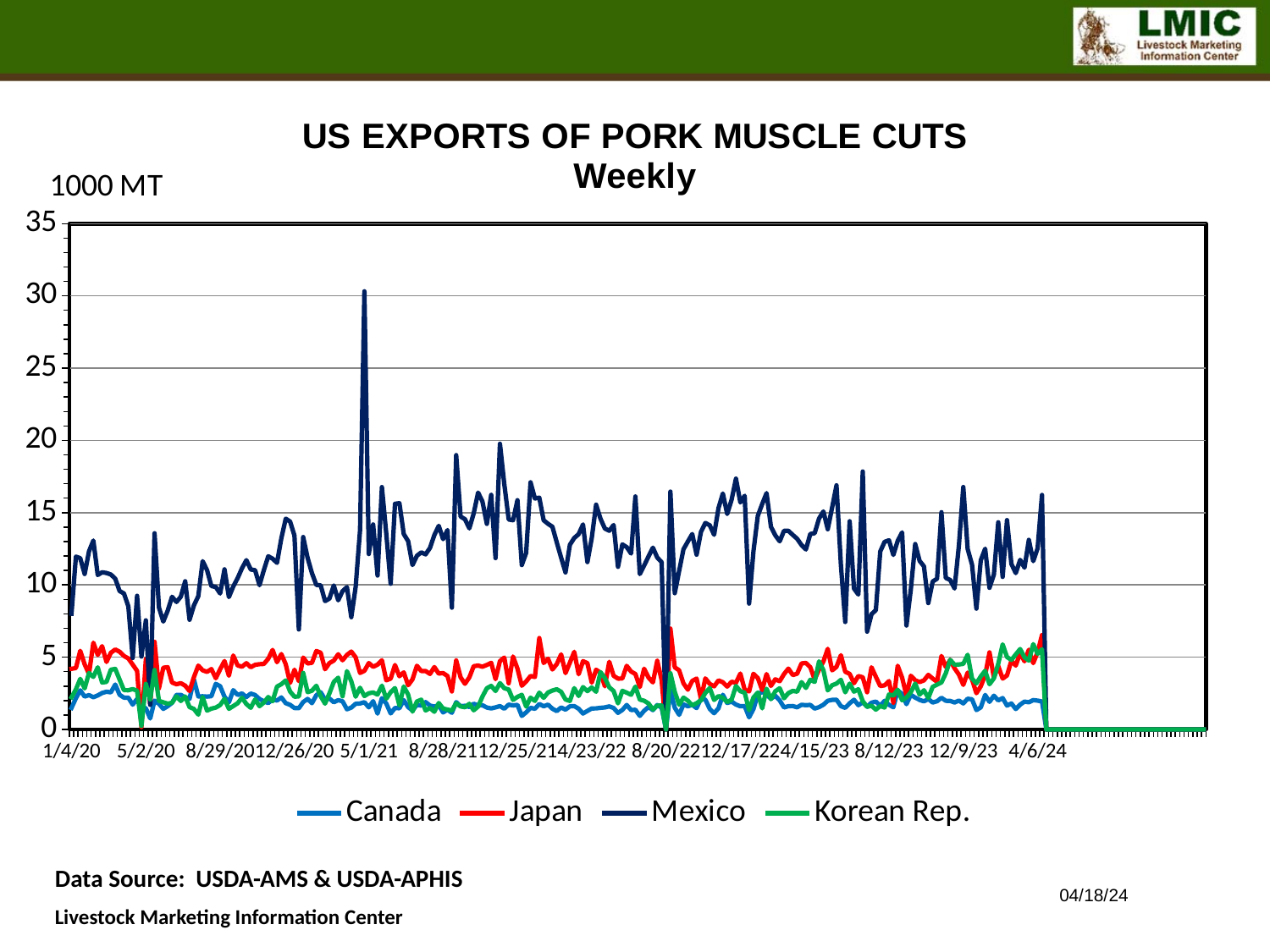
Is the peak value for Mexico near 5/1/21 greater or less than 25? greater How many series does the legend list? 4 What is the first date label on the x axis? 1/4/20 Which series has the lowest values across most of the chart? Canada Around 8/28/21, which is larger, the value for Mexico or the value for Canada? Mexico What kind of chart is shown on the slide? line chart Is the value for Canada throughout the chart greater or less than 5? less What unit is shown for the vertical axis? 1000 MT What is the title of the chart? US EXPORTS OF PORK MUSCLE CUTS Weekly Is the value for Japan at any point greater or less than 10? less Around 4/6/24, which is larger, the value for Korean Rep. or the value for Canada? Korean Rep. Which series has the highest values across the chart? Mexico